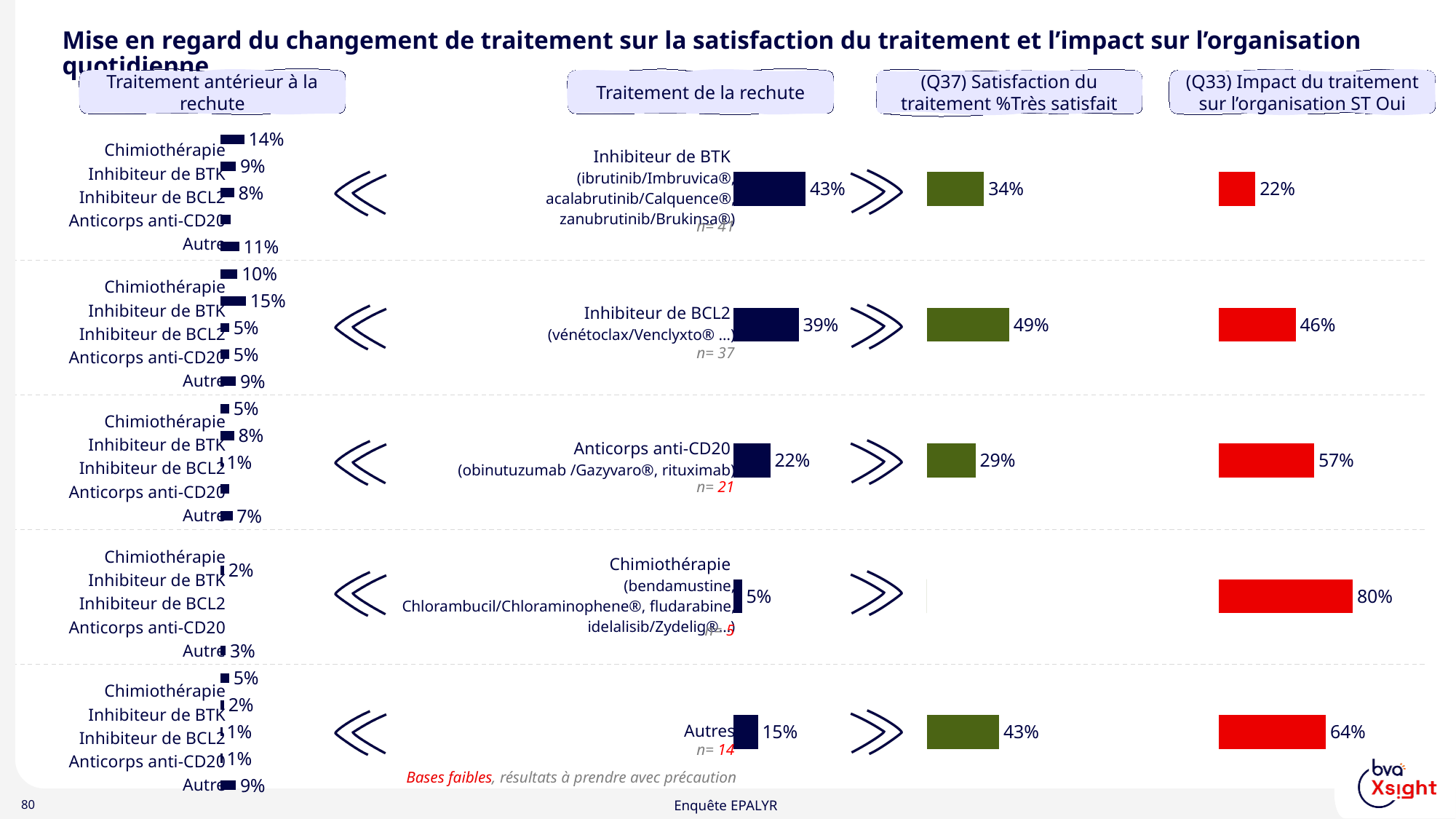
In the 'Traitement de la rechute' chart, what is the value for Anticorps anti-CD20? 22% In the '(Q37) Satisfaction du traitement %Très satisfait' chart, what is the difference between Inhibiteur de BCL2 and Inhibiteur de BTK? 15% In the '(Q33) Impact du traitement sur l'organisation ST Oui' chart, which is larger: Anticorps anti-CD20 or Inhibiteur de BCL2? Anticorps anti-CD20 What kind of chart is used in the 'Traitement de la rechute' column? Bar chart In the 'Traitement de la rechute' chart, which treatment has the highest value? Inhibiteur de BTK In the 'Traitement de la rechute' chart, what is the value for Inhibiteur de BTK? 43% In the '(Q37) Satisfaction du traitement %Très satisfait' chart, what is the value for Inhibiteur de BCL2? 49% In the '(Q33) Impact du traitement sur l'organisation ST Oui' chart, which treatment has the lowest value? Inhibiteur de BTK In the 'Traitement antérieur à la rechute' chart for the Inhibiteur de BCL2 row, what is the value for Inhibiteur de BTK? 15% In the 'Traitement de la rechute' chart, which treatment has the lowest value? Chimiothérapie In the 'Traitement antérieur à la rechute' chart for the Inhibiteur de BTK row, what is the value for Chimiothérapie? 14% In the '(Q33) Impact du traitement sur l'organisation ST Oui' chart, what is the value for Chimiothérapie? 80%